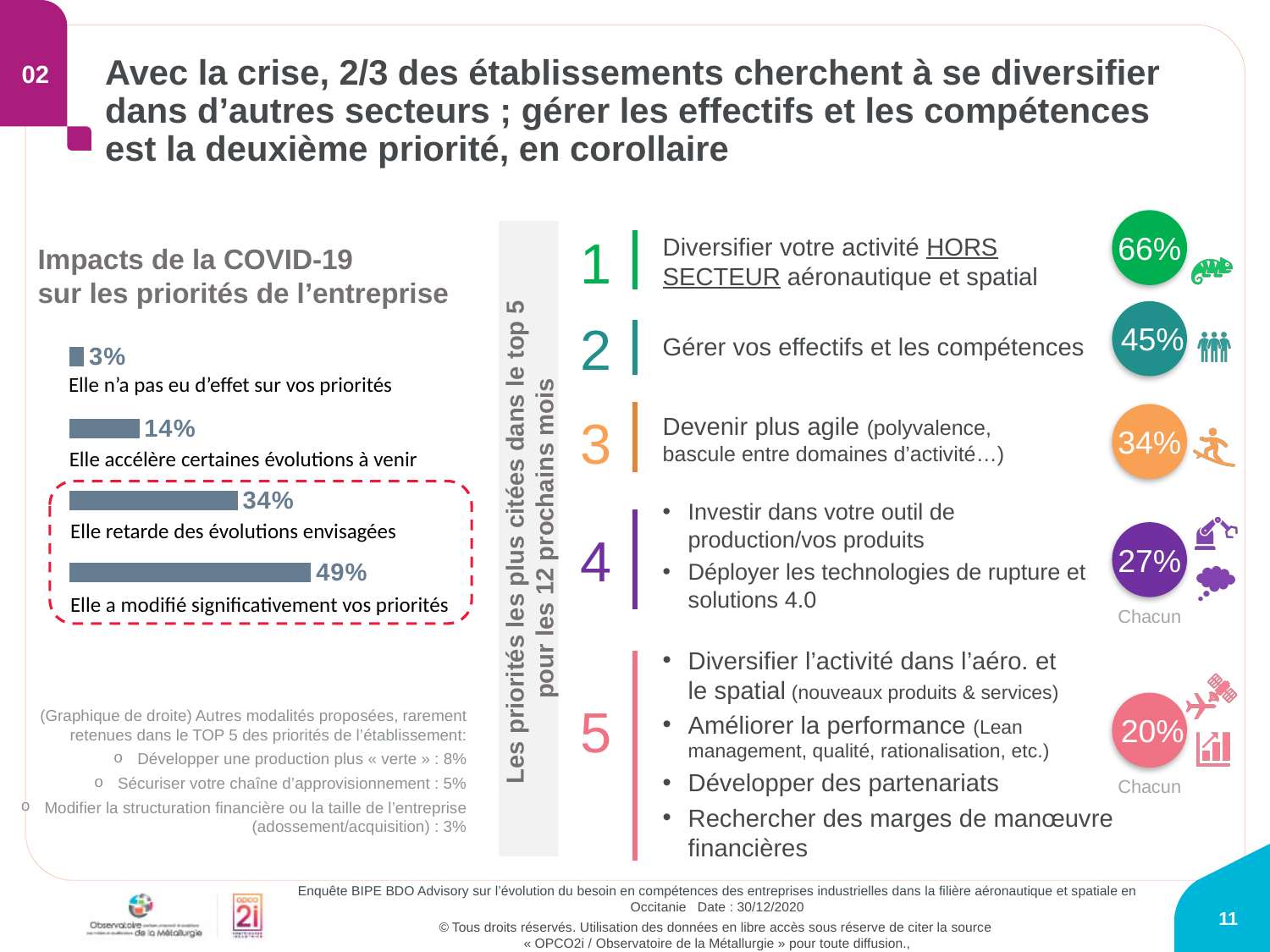
In the bar chart 'Impacts de la COVID-19 sur les priorités de l'entreprise', what is the value for 'Elle accélère certaines évolutions à venir'? 14% In the bar chart 'Impacts de la COVID-19 sur les priorités de l'entreprise', which is larger: 'Elle accélère certaines évolutions à venir' or 'Elle retarde des évolutions envisagées'? Elle retarde des évolutions envisagées In the bar chart 'Impacts de la COVID-19 sur les priorités de l'entreprise', what is the combined value of the two categories enclosed in the red dashed box? 83% In the bar chart 'Impacts de la COVID-19 sur les priorités de l'entreprise', what is the difference between 'Elle a modifié significativement vos priorités' and 'Elle retarde des évolutions envisagées'? 15% In the bar chart 'Impacts de la COVID-19 sur les priorités de l'entreprise', what is the value for 'Elle a modifié significativement vos priorités'? 49% What type of chart is 'Impacts de la COVID-19 sur les priorités de l'entreprise'? Bar chart How many categories does the bar chart 'Impacts de la COVID-19 sur les priorités de l'entreprise' show? 4 In the bar chart 'Impacts de la COVID-19 sur les priorités de l'entreprise', what is the value for 'Elle n'a pas eu d'effet sur vos priorités'? 3% In the bar chart 'Impacts de la COVID-19 sur les priorités de l'entreprise', what is the value for 'Elle retarde des évolutions envisagées'? 34% In the bar chart 'Impacts de la COVID-19 sur les priorités de l'entreprise', which category has the highest value? Elle a modifié significativement vos priorités In the ranked list on the right of the slide, what percentage is shown for priority 1, 'Diversifier votre activité HORS SECTEUR aéronautique et spatial'? 66% In the bar chart 'Impacts de la COVID-19 sur les priorités de l'entreprise', which category has the lowest value? Elle n'a pas eu d'effet sur vos priorités